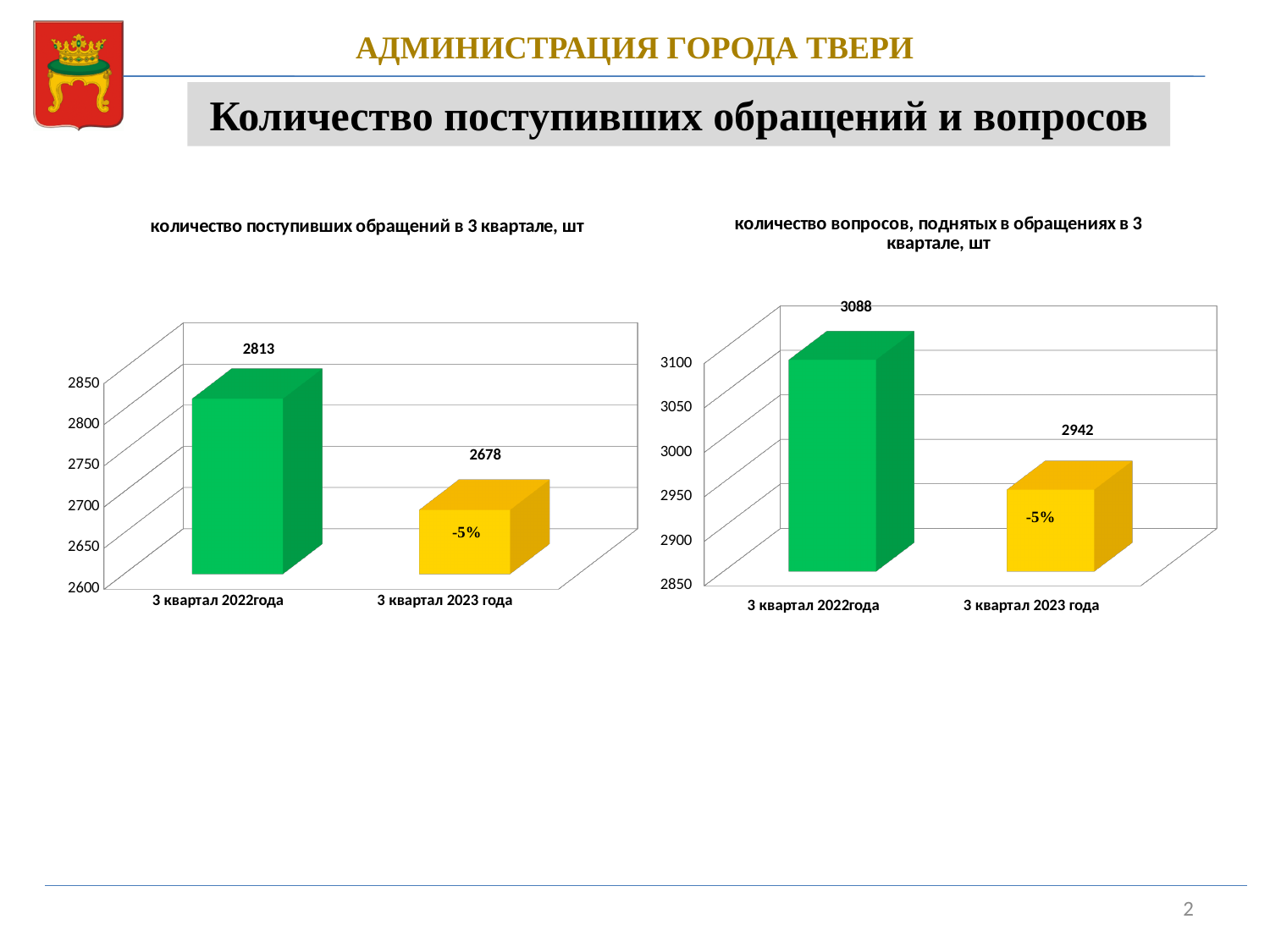
In the left chart (количество поступивших обращений в 3 квартале, шт), what is the value for 3 квартал 2022года? 2813 In the right chart (количество вопросов, поднятых в обращениях в 3 квартале, шт), what is the value for 3 квартал 2022года? 3088 In the right chart, which category has the lowest value? 3 квартал 2023 года In the left chart, which category has the highest value? 3 квартал 2022года In the left chart, what percentage change label is printed on the bar for 3 квартал 2023 года? -5% In the right chart, what is the difference between the values for 3 квартал 2022года and 3 квартал 2023 года? 146 How many categories are shown in the right chart? 2 In the left chart, what is the difference between the values for 3 квартал 2022года and 3 квартал 2023 года? 135 In the left chart (количество поступивших обращений в 3 квартале, шт), what is the value for 3 квартал 2023 года? 2678 In the right chart (количество вопросов, поднятых в обращениях в 3 квартале, шт), what is the value for 3 квартал 2023 года? 2942 What kind of chart is the left chart? Bar chart In the right chart, which is larger: the value for 3 квартал 2022года or 3 квартал 2023 года? 3 квартал 2022года